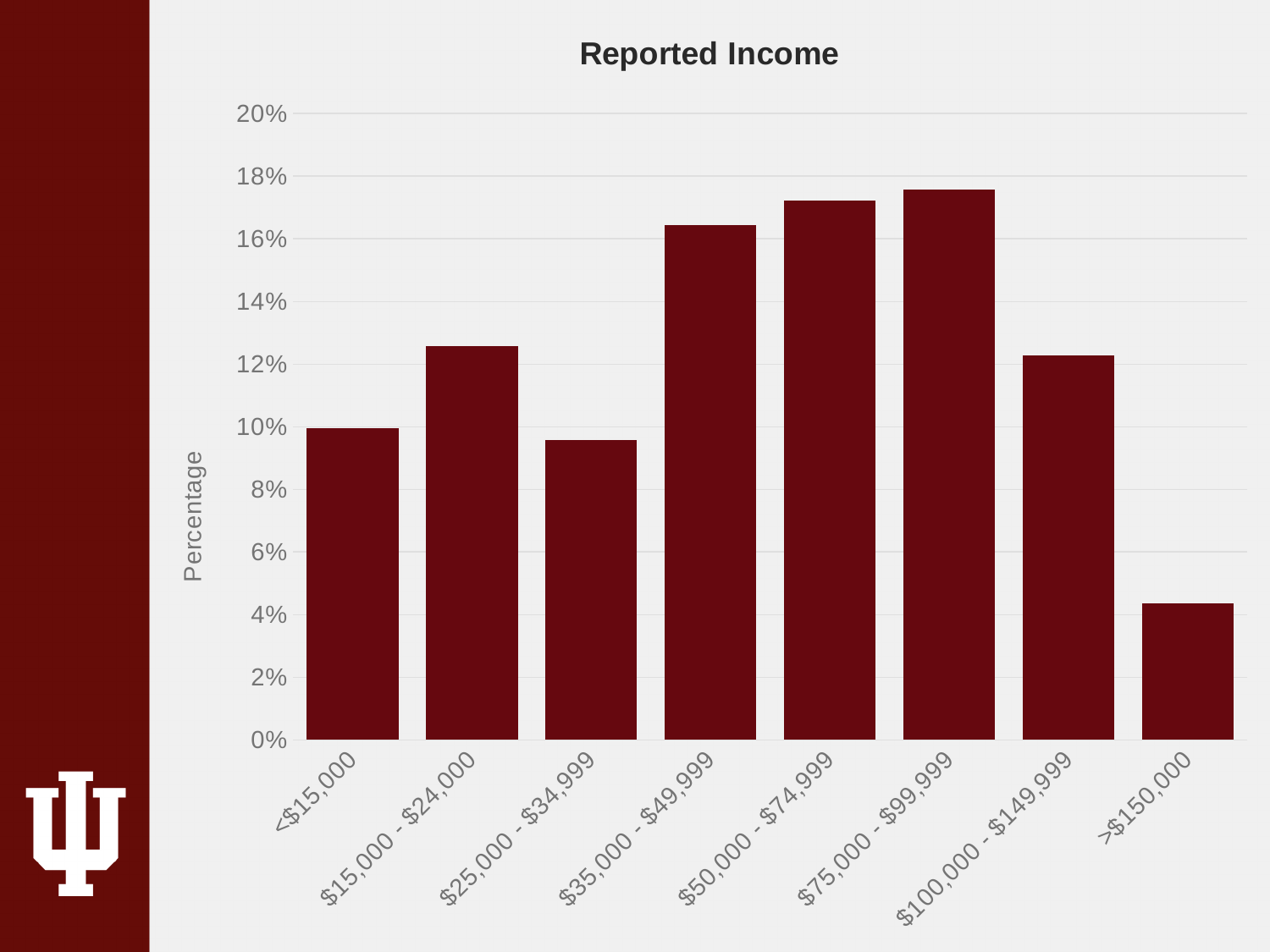
Which is larger, the value for $15,000 - $24,000 or the value for $25,000 - $34,999? $15,000 - $24,000 How many income categories are shown on the x axis? 8 Is the value for $100,000 - $149,999 greater or less than 10%? greater Which income category has the lowest percentage? >$150,000 What is the title of the chart? Reported Income What kind of chart is shown on the slide? bar chart Is the value for $75,000 - $99,999 greater or less than 18%? less Is the value for $25,000 - $34,999 greater or less than 10%? less Which is larger, the value for $35,000 - $49,999 or the value for $100,000 - $149,999? $35,000 - $49,999 What is the label on the vertical axis of the chart? Percentage